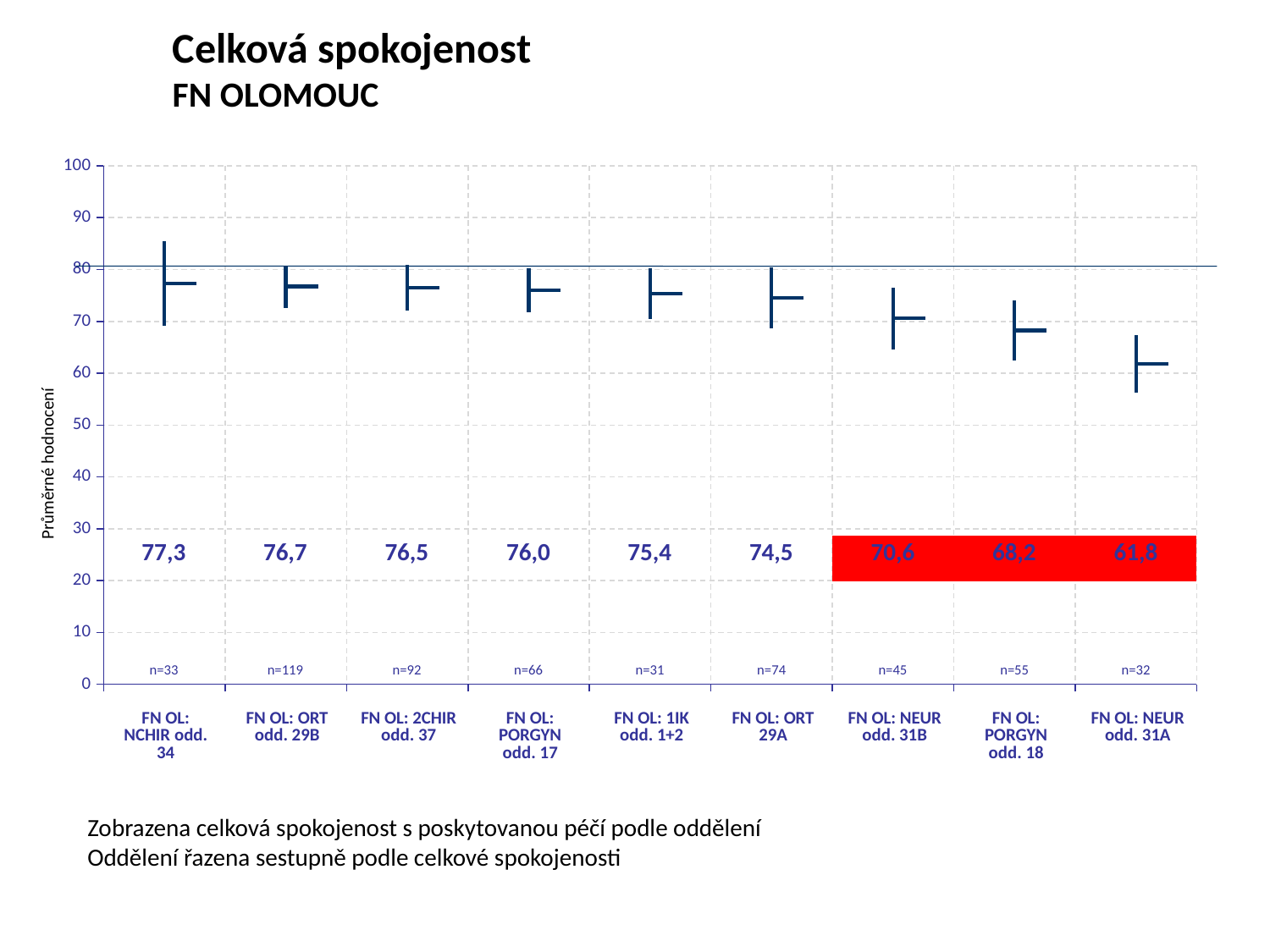
What is the average rating for FN OL: NEUR odd. 31A? 61,8 What is the difference between the average ratings of FN OL: NCHIR odd. 34 and FN OL: NEUR odd. 31A? 15,5 What is the average rating for FN OL: NCHIR odd. 34? 77,3 How many departments are shown on the chart? 9 How many departments have their value label highlighted with a red background? 3 What is the average rating for FN OL: PORGYN odd. 18? 68,2 Do the average ratings rise or fall from left to right along the x axis? fall Which has a higher average rating, FN OL: ORT 29A or FN OL: NEUR odd. 31B? FN OL: ORT 29A What is the title of the chart? Celková spokojenost What is the sample size (n) for FN OL: ORT odd. 29B? n=119 Which department has the highest average rating? FN OL: NCHIR odd. 34 Which department has the lowest average rating? FN OL: NEUR odd. 31A